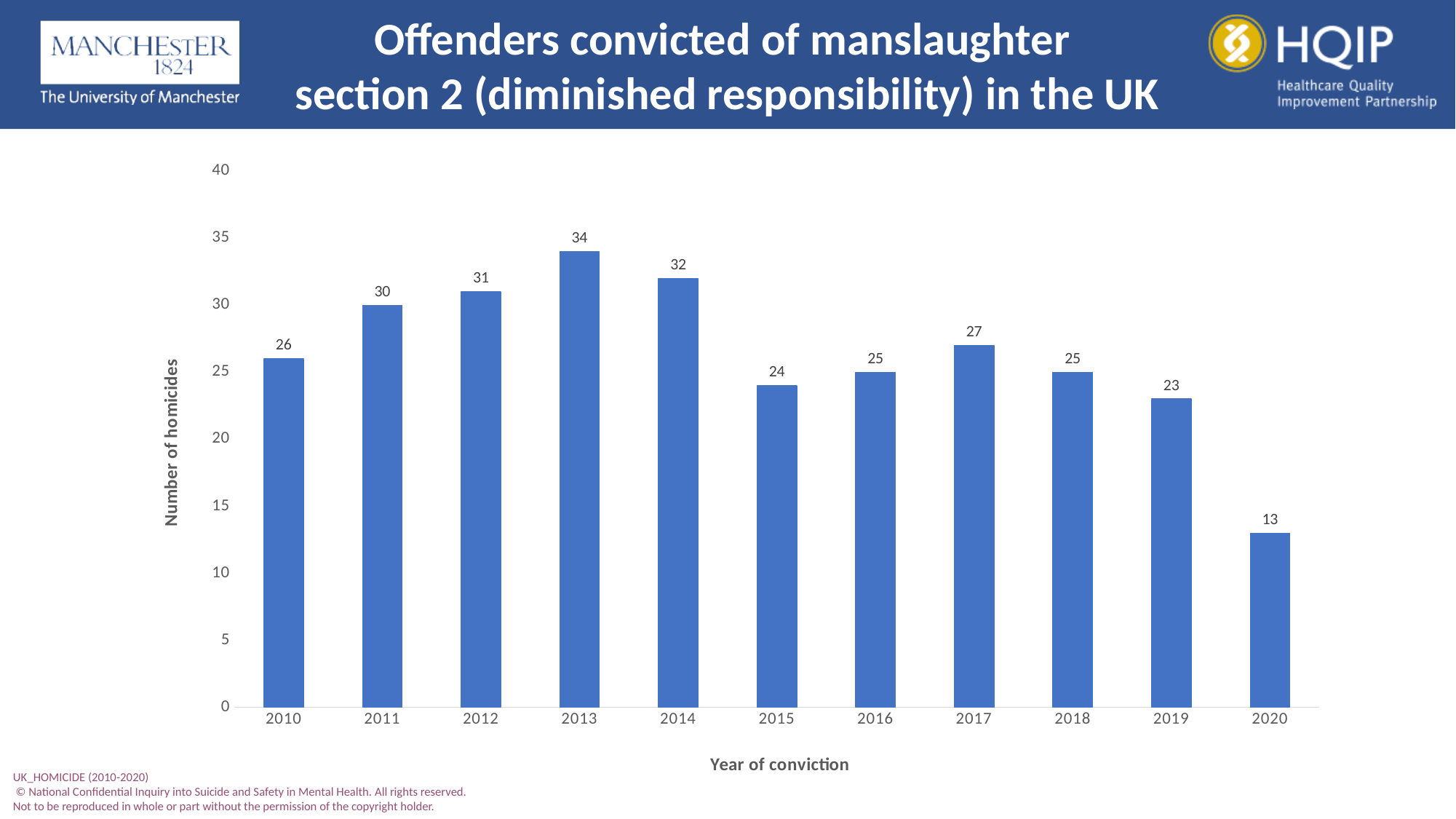
What is the difference between the number of homicides in 2014 and 2015? 8 Which year has the highest number of homicides? 2013 What is the label of the y axis? Number of homicides What is the number of homicides for 2017? 27 What is the number of homicides for 2020? 13 What is the difference between the number of homicides in 2013 and 2020? 21 Is the value for 2012 greater or less than 30? greater What kind of chart is shown on the slide? Bar chart What is the number of homicides for 2013? 34 Which year has the lowest number of homicides? 2020 How many years are shown on the x axis? 11 Which year has more homicides, 2011 or 2019? 2011